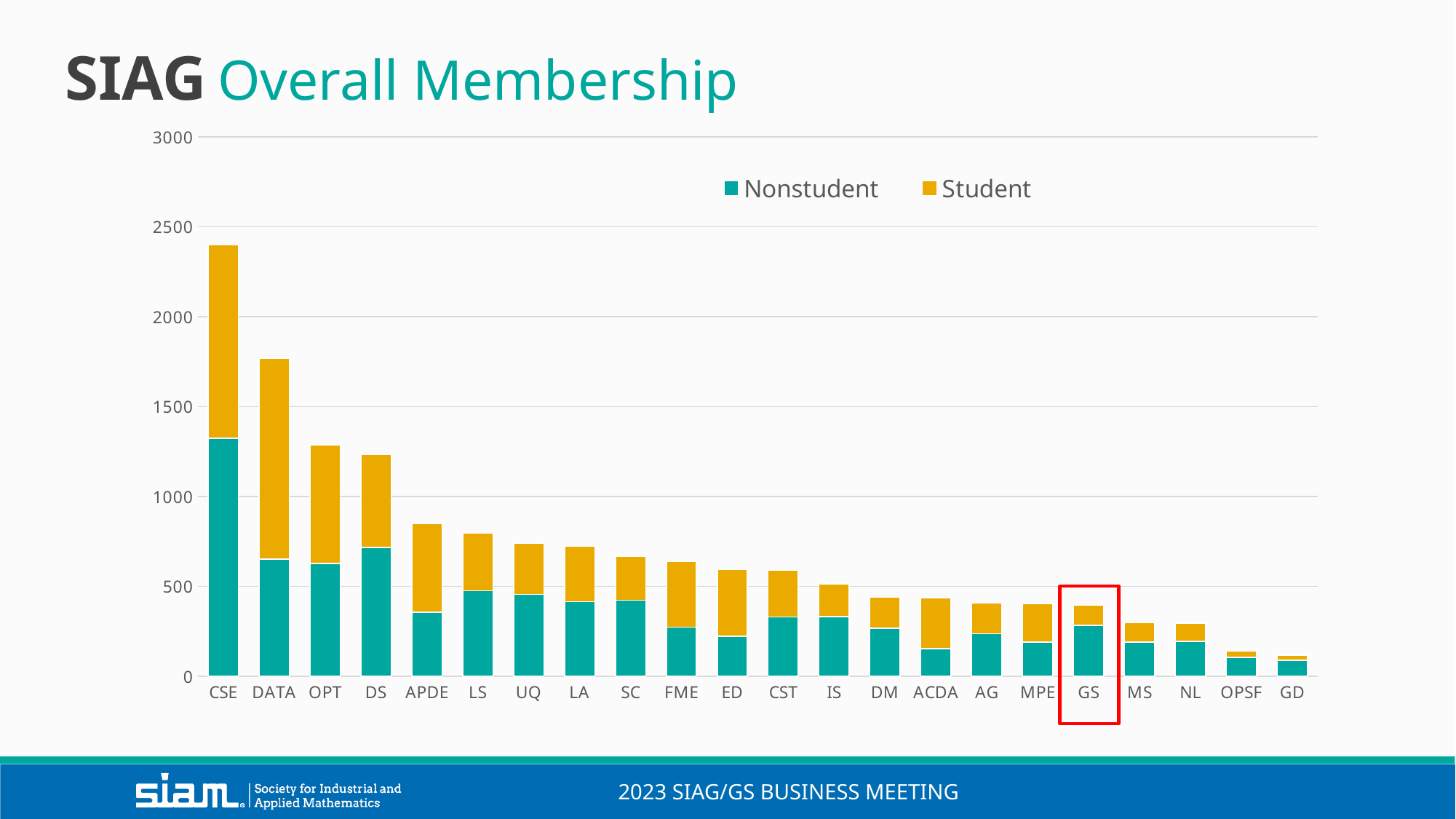
Which has the larger total membership, GS or MS? GS Is the Nonstudent value for CSE greater or less than 1000? greater Is the total membership for DATA greater or less than 1500? greater Is the total membership for CSE greater or less than 2000? greater Which SIAG has the lowest overall membership? GD Which SIAG has the highest overall membership? CSE Which category on the chart is highlighted with a red box? GS How many series does the legend list? 2 What kind of chart is shown on the slide? Stacked bar chart Do the total bar heights rise or fall moving from left to right along the x axis? fall How many SIAG categories are shown along the x axis? 22